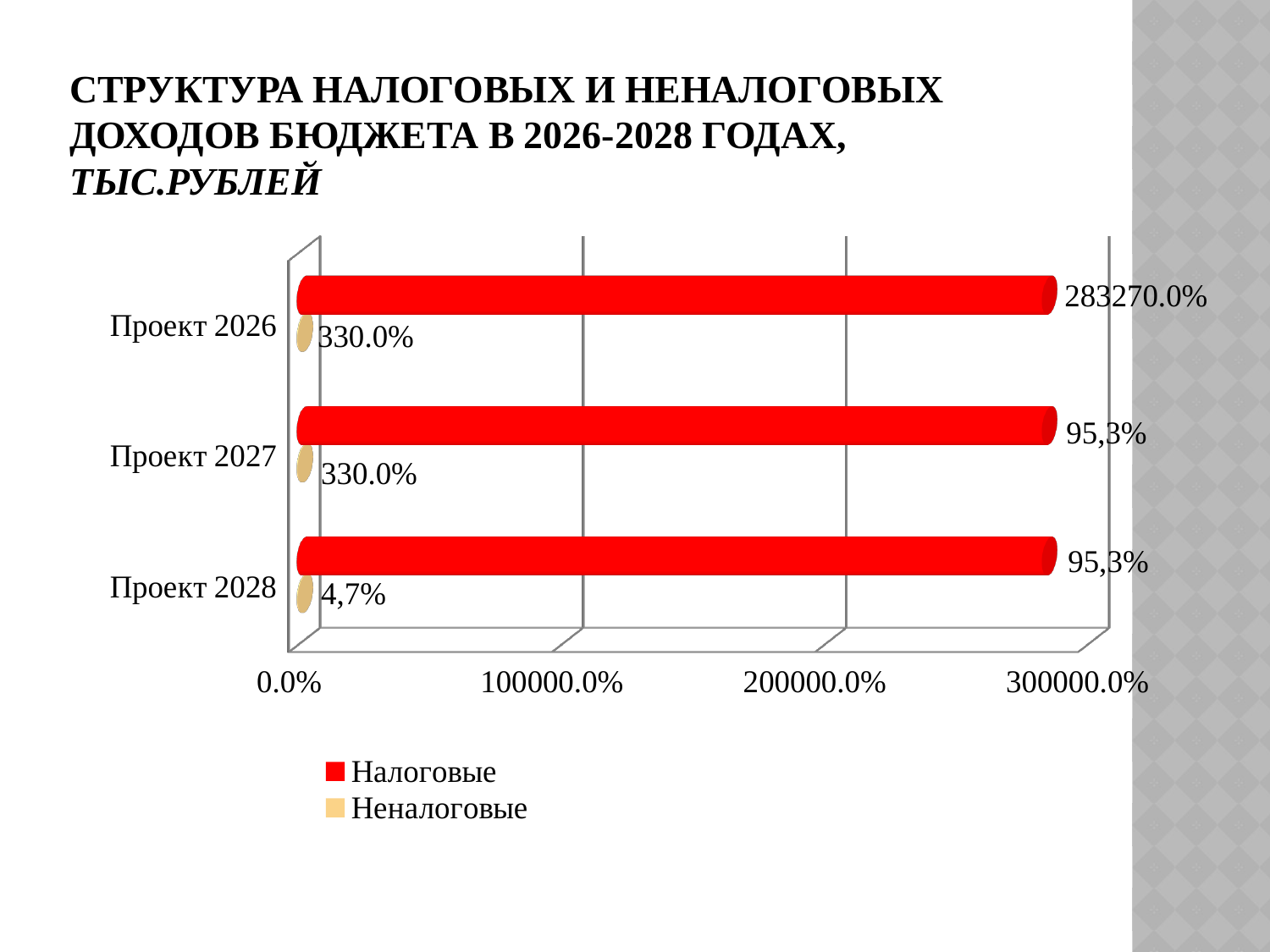
What kind of chart is shown on the slide? bar chart What is the data label on the Неналоговые bar for Проект 2026? 330.0% How many series does the legend list? 2 What is the data label on the Налоговые bar for Проект 2027? 95,3% What is the data label on the Налоговые bar for Проект 2026? 283270.0% What is the data label on the Неналоговые bar for Проект 2028? 4,7% Which series is shown in red in the legend? Налоговые For Проект 2026, which bar is longer: Налоговые or Неналоговые? Налоговые What is the highest value shown on the horizontal axis? 300000.0% What is the data label on the Неналоговые bar for Проект 2027? 330.0% Is the Налоговые bar for Проект 2028 greater or less than 200000.0% on the axis? greater How many categories (projects) are shown on the chart? 3